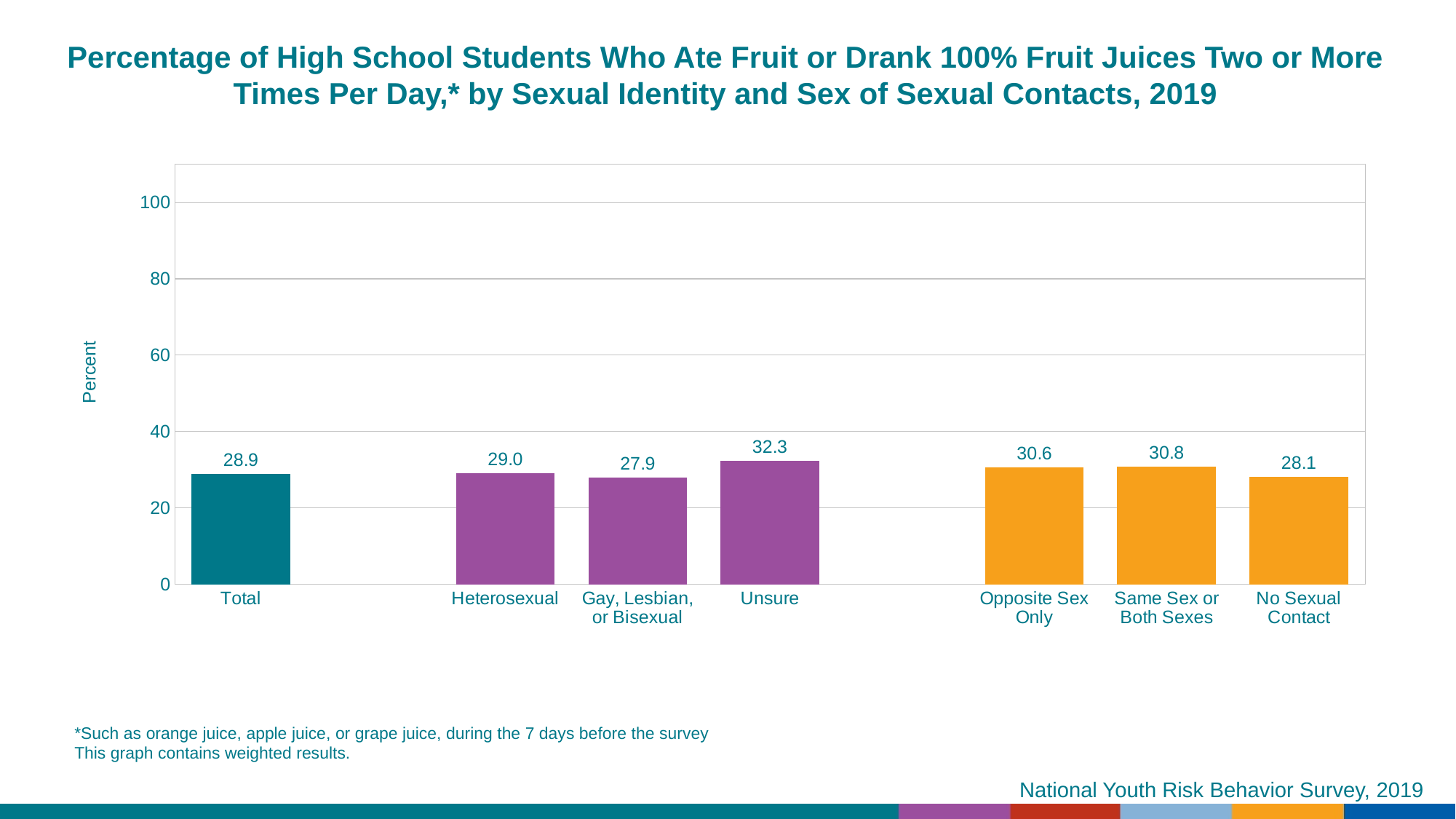
How many categories are shown on the chart? 7 What is the difference between the values for Opposite Sex Only and No Sexual Contact? 2.5 Which category has the lowest value? Gay, Lesbian, or Bisexual What is the difference between the values for Unsure and Heterosexual? 3.3 What is the value for Gay, Lesbian, or Bisexual? 27.9 What kind of chart is shown on the slide? bar chart What is the value for Unsure? 32.3 Which is larger, the value for Unsure or the value for No Sexual Contact? Unsure Is the value for Heterosexual greater or less than 40? less What is the value for Total? 28.9 Which category has the highest value? Unsure What is the value for Same Sex or Both Sexes? 30.8